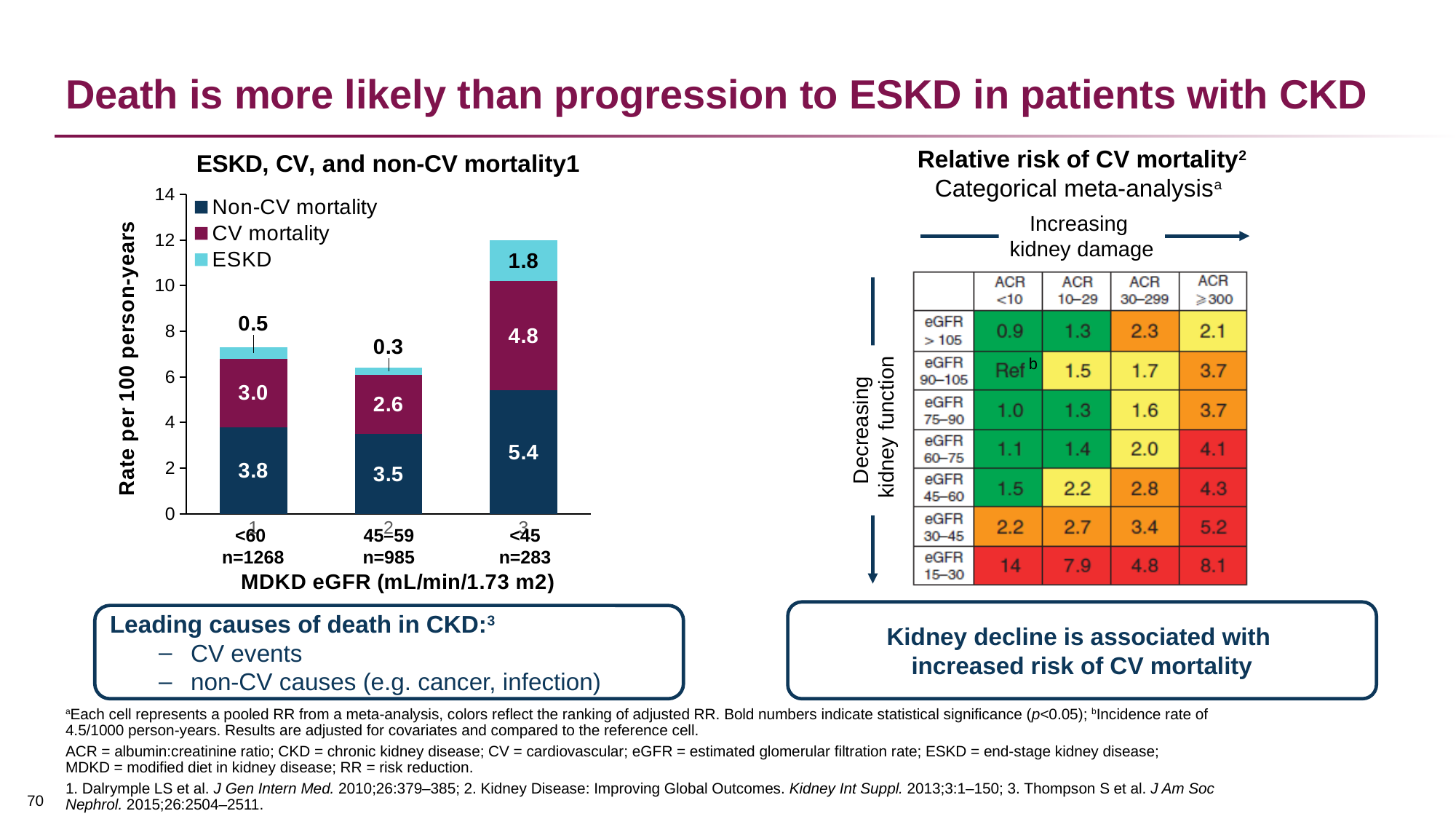
In the 'ESKD, CV, and non-CV mortality' chart, what is the total stacked rate for the <45 eGFR group? 12.0 In the 'ESKD, CV, and non-CV mortality' chart, what is the CV mortality rate for the 45–59 eGFR group? 2.6 In the 'ESKD, CV, and non-CV mortality' chart, which eGFR group has the lowest ESKD rate? 45–59 In the 'ESKD, CV, and non-CV mortality' chart, what is the total stacked rate for the 45–59 eGFR group? 6.4 In the 'ESKD, CV, and non-CV mortality' chart, which is larger: the CV mortality rate for <60 or for 45–59? <60 How many eGFR groups are shown on the x axis of the 'ESKD, CV, and non-CV mortality' chart? 3 In the 'ESKD, CV, and non-CV mortality' chart, which eGFR group has the highest CV mortality rate? <45 How many series does the legend of the 'ESKD, CV, and non-CV mortality' chart list? 3 In the 'ESKD, CV, and non-CV mortality' chart, what is the difference between the non-CV mortality rates of the <45 and <60 groups? 1.6 In the 'ESKD, CV, and non-CV mortality' chart, what is the ESKD rate for the <60 eGFR group? 0.5 In the 'ESKD, CV, and non-CV mortality' chart, what is the non-CV mortality rate for the <45 eGFR group? 5.4 What type of chart is the 'ESKD, CV, and non-CV mortality' chart? Stacked bar chart